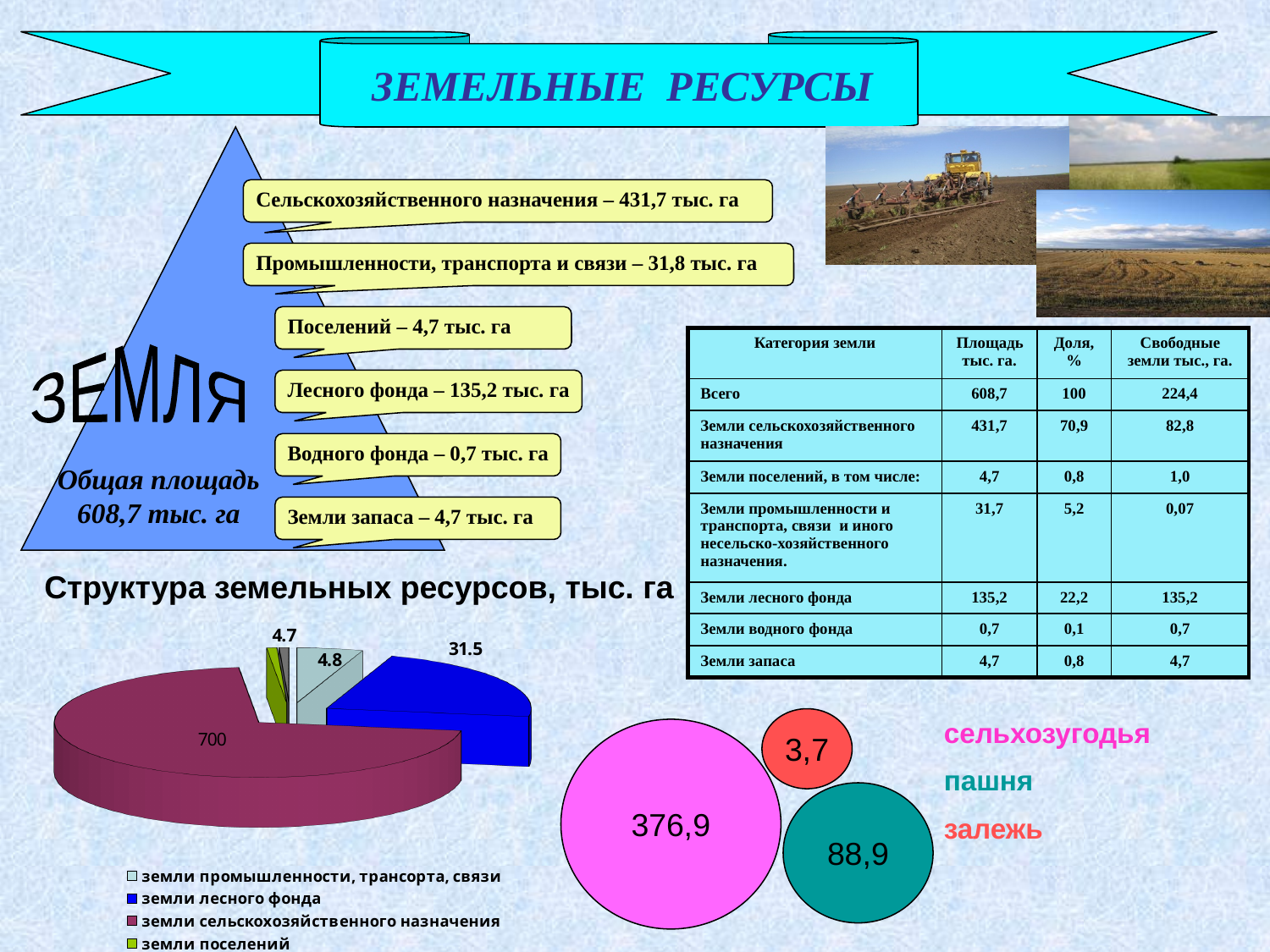
What kind of chart is the chart titled "Структура земельных ресурсов, тыс. га"? pie chart In the circle diagram at the bottom right of the slide, what value is shown for пашня? 88,9 In the circle diagram at the bottom right of the slide, what value is shown for сельхозугодья? 376,9 In the pie chart "Структура земельных ресурсов, тыс. га", which category has the largest slice? земли сельскохозяйственного назначения In the pie chart "Структура земельных ресурсов, тыс. га", how many categories does the legend list? 4 In the pie chart "Структура земельных ресурсов, тыс. га", which is larger: земли лесного фонда or земли поселений? земли лесного фонда In the circle diagram at the bottom right of the slide, which category has the smallest value? залежь